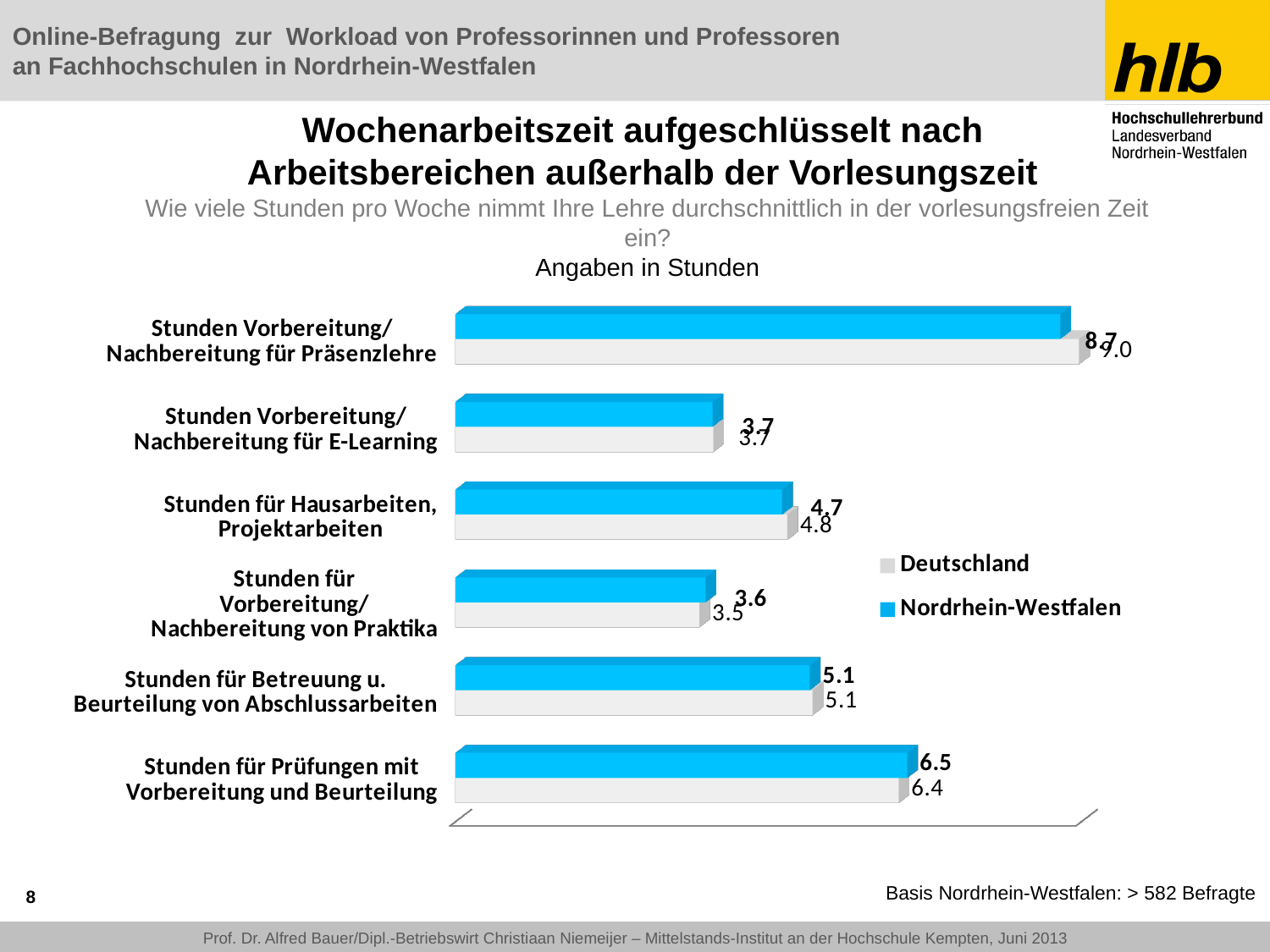
How many series does the legend list? 2 What is the value for Deutschland for 'Stunden für Prüfungen mit Vorbereitung und Beurteilung'? 6.4 What is the difference between the Nordrhein-Westfalen and Deutschland values for 'Stunden für Prüfungen mit Vorbereitung und Beurteilung'? 0.1 What is the value for Nordrhein-Westfalen for 'Stunden für Prüfungen mit Vorbereitung und Beurteilung'? 6.5 What is the value for Nordrhein-Westfalen for 'Stunden für Vorbereitung/Nachbereitung von Praktika'? 3.6 Which category has the lowest value for Deutschland? Stunden für Vorbereitung/Nachbereitung von Praktika What kind of chart is shown on the slide? bar chart What is the value for Deutschland for 'Stunden für Hausarbeiten, Projektarbeiten'? 4.8 What is the value for Nordrhein-Westfalen for 'Stunden für Hausarbeiten, Projektarbeiten'? 4.7 Which category has the highest value for Nordrhein-Westfalen? Stunden Vorbereitung/Nachbereitung für Präsenzlehre Which colour represents Nordrhein-Westfalen in the chart? blue How many categories (Arbeitsbereiche) are shown in the chart? 6